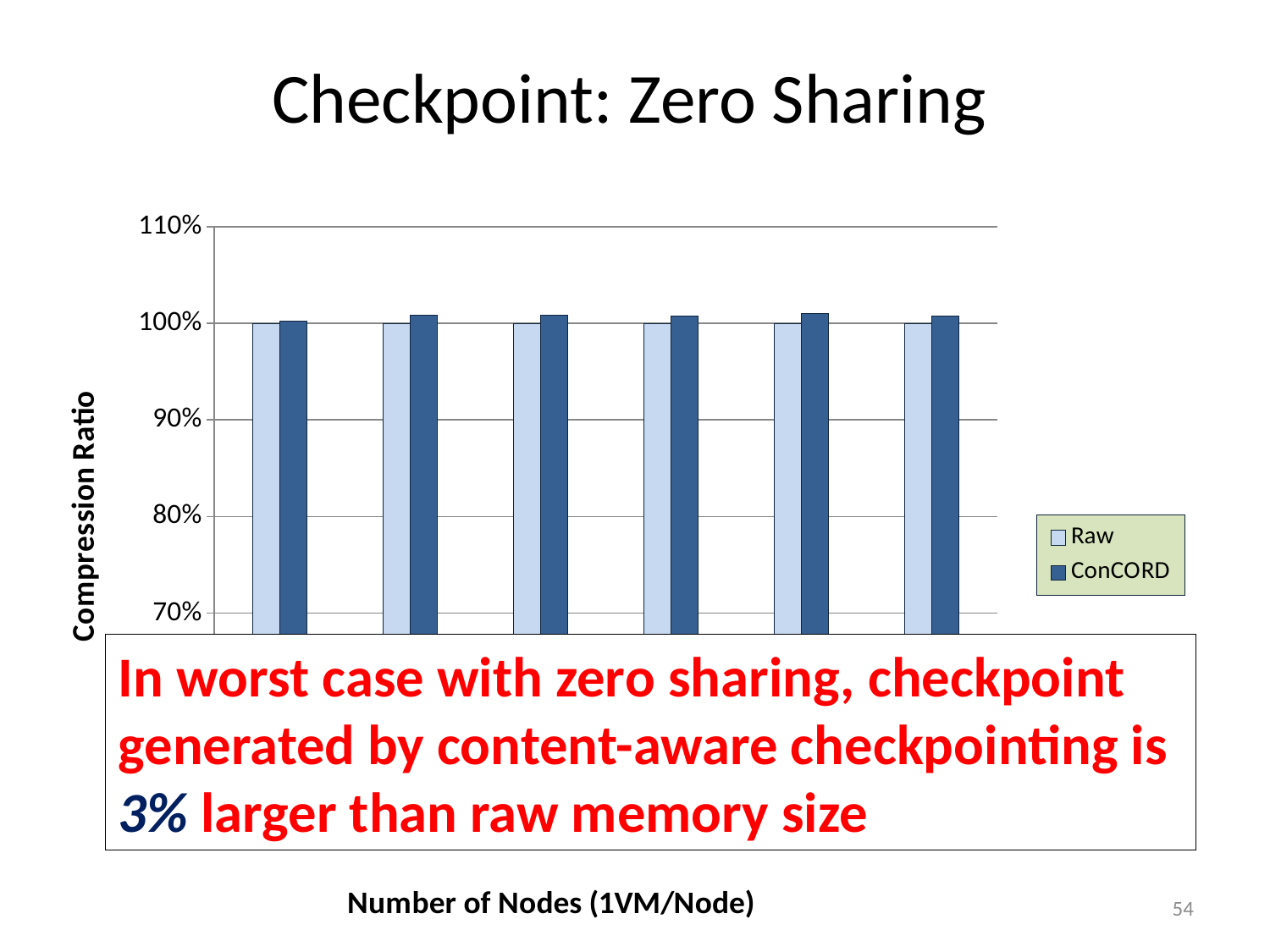
What is the title of the chart's vertical axis? Compression Ratio What value do the Raw bars reach on the vertical axis? 100% Do the Raw bars rise, fall, or stay flat across the groups along the x axis? stay flat Are the ConCORD bars greater or less than 110%? less Are the ConCORD bars greater or less than 90%? greater What kind of chart is shown on the slide? bar chart How many series does the legend list? 2 Are the Raw bars greater or less than 80%? greater What are the two series named in the legend? Raw and ConCORD In each group, which series has the taller bar, Raw or ConCORD? ConCORD How many groups of bars are plotted in the chart? 6 What is the lowest value shown on the vertical axis? 70%